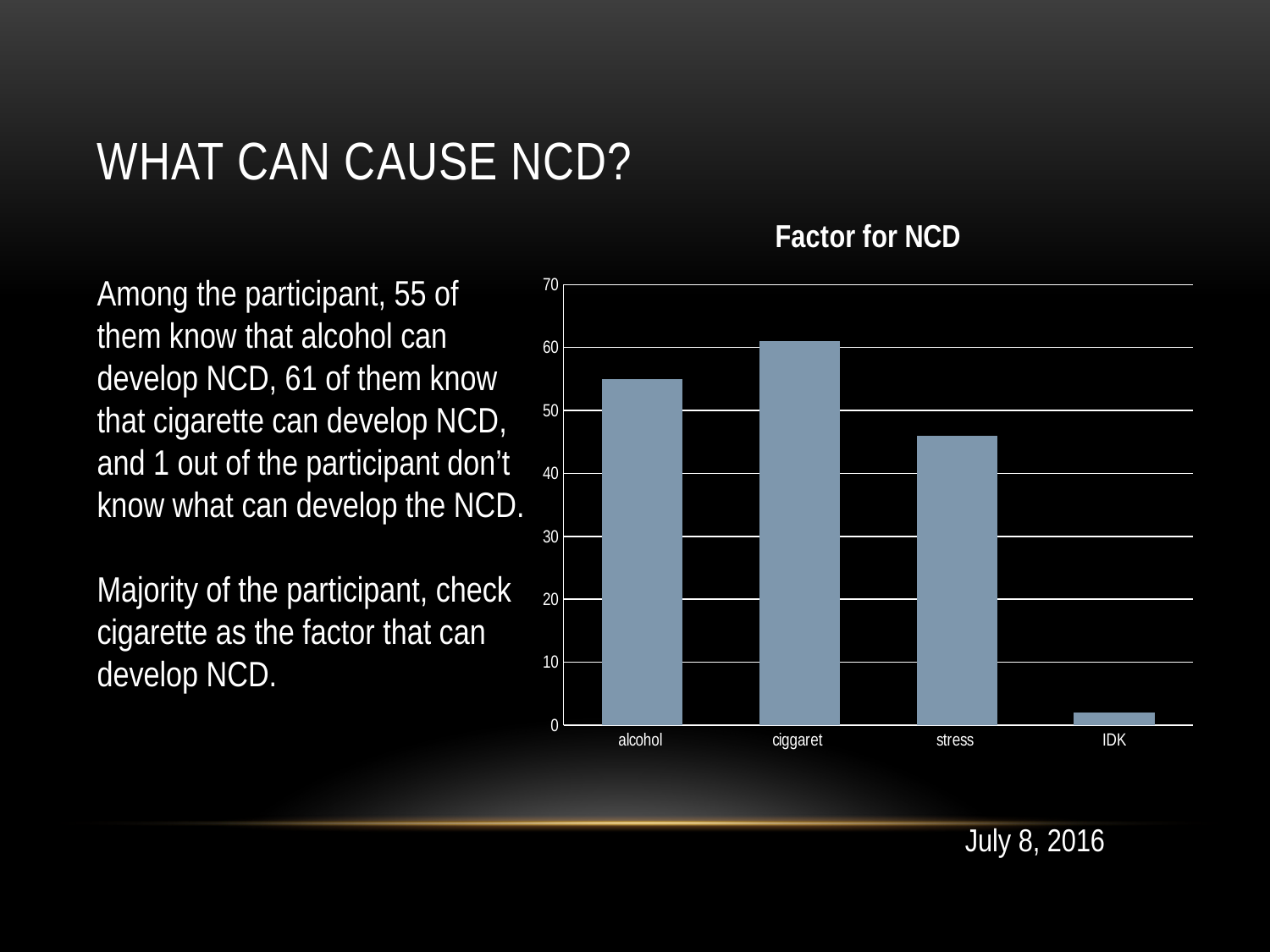
Which category has the lowest bar in the chart? IDK Which category has the highest bar in the chart? ciggaret Which is larger, the value for alcohol or the value for stress? alcohol Is the value for alcohol greater or less than 50? greater What is the title of the chart? Factor for NCD Which is larger, the value for ciggaret or the value for alcohol? ciggaret Is the value for stress greater or less than 50? less Is the value for stress greater or less than 40? greater How many categories are shown on the x axis of the chart? 4 What type of chart is shown on the slide? bar chart